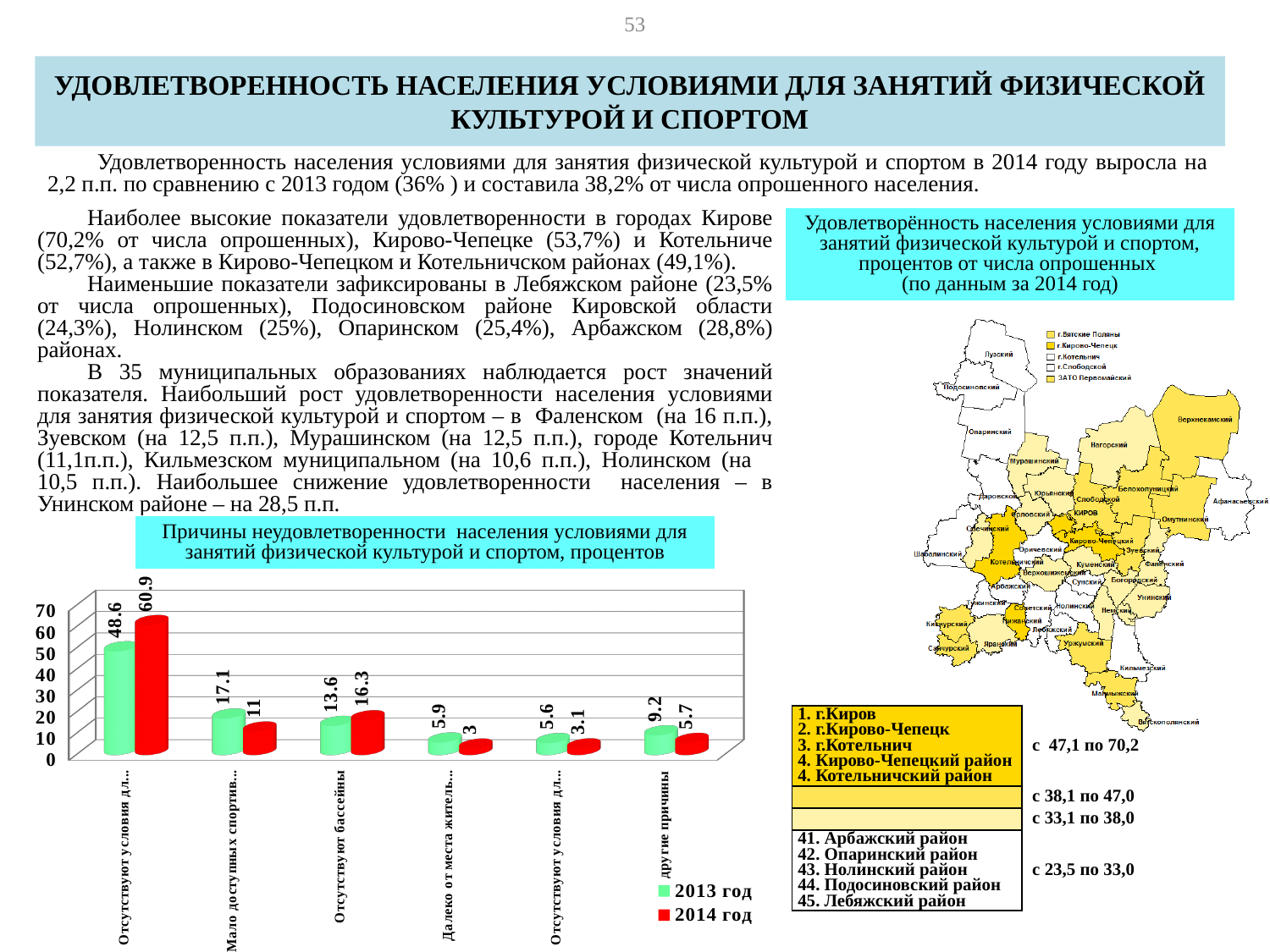
In the bar chart on the causes of dissatisfaction, how many series does the legend list? 2 In the bar chart on the causes of dissatisfaction, how many categories are shown on the x axis? 6 In the bar chart on the causes of dissatisfaction, what is the 2014 год value for "другие причины"? 5.7 In the bar chart on the causes of dissatisfaction, what is the difference between the 2013 год and 2014 год values for "другие причины"? 3.5 In the bar chart on the causes of dissatisfaction, which is larger for "другие причины": the 2013 год value or the 2014 год value? 2013 год In the bar chart on the causes of dissatisfaction, what are the two series named in the legend? 2013 год and 2014 год In the bar chart on the causes of dissatisfaction, what is the difference between the 2014 год and 2013 год values for "Отсутствуют бассейны"? 2.7 In the bar chart on the causes of dissatisfaction, what is the 2013 год value for "другие причины"? 9.2 What type of chart is shown under the title "Причины неудовлетворенности населения условиями для занятий физической культурой и спортом, процентов"? bar chart In the bar chart on the causes of dissatisfaction, what is the highest 2014 год value shown? 60.9 In the bar chart on the causes of dissatisfaction, what is the 2013 год value for "Отсутствуют бассейны"? 13.6 In the bar chart on the causes of dissatisfaction, what is the 2014 год value for "Отсутствуют бассейны"? 16.3